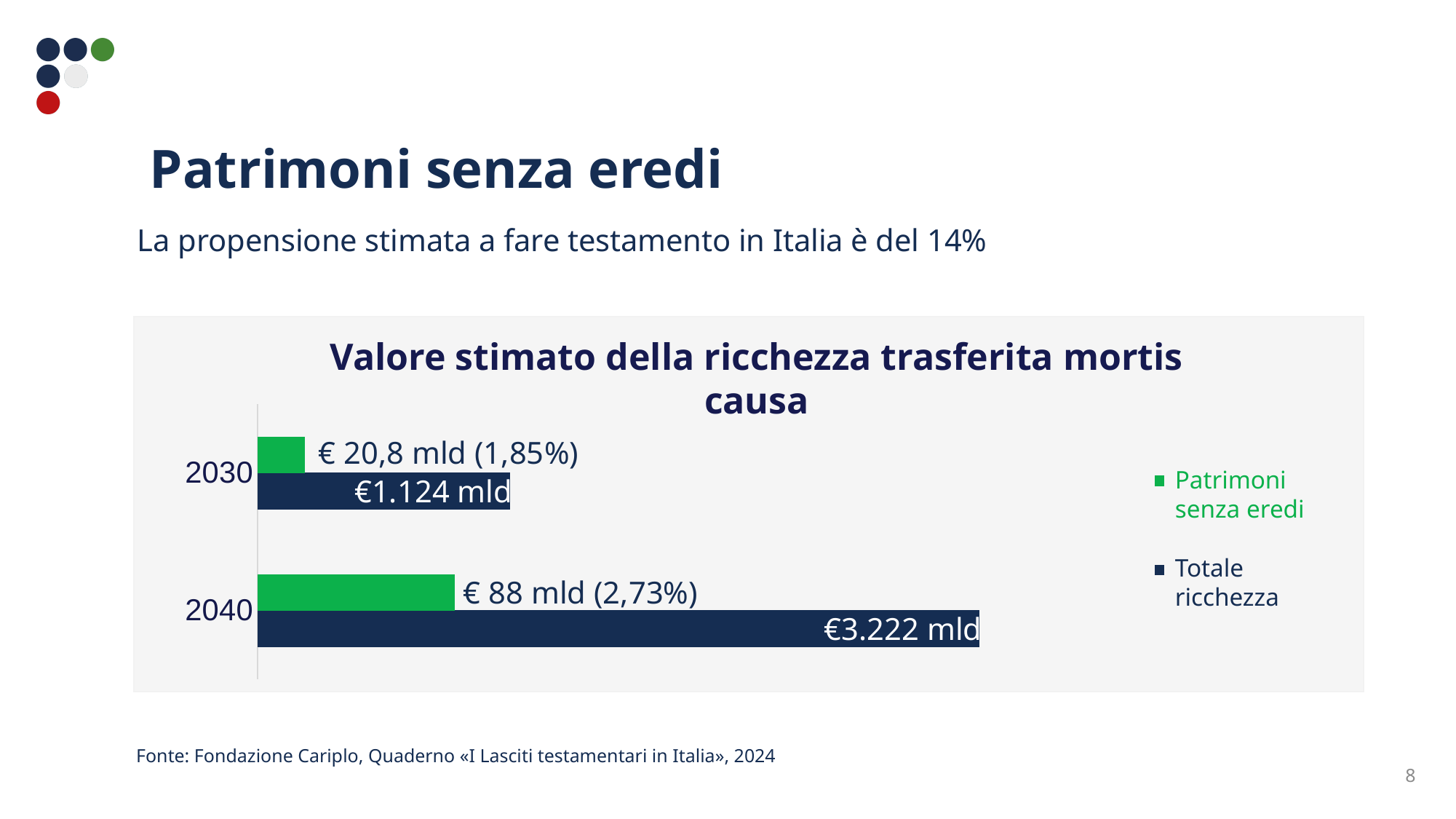
What is the value of Patrimoni senza eredi for 2030? € 20,8 mld (1,85%) How many years (categories) are shown on the chart? 2 What percentage is shown next to the Patrimoni senza eredi value for 2040? 2,73% Which year has the higher Totale ricchezza value? 2040 What is the difference in Patrimoni senza eredi between 2040 and 2030? € 67,2 mld What is the value of Totale ricchezza for 2040? €3.222 mld What type of chart is shown on the slide? bar chart Is the Patrimoni senza eredi value for 2040 larger or smaller than the Totale ricchezza value for 2030? smaller How many series does the legend list? 2 Which year has the lower Patrimoni senza eredi value? 2030 What is the value of Totale ricchezza for 2030? €1.124 mld What is the difference in Totale ricchezza between 2040 and 2030? €2.098 mld